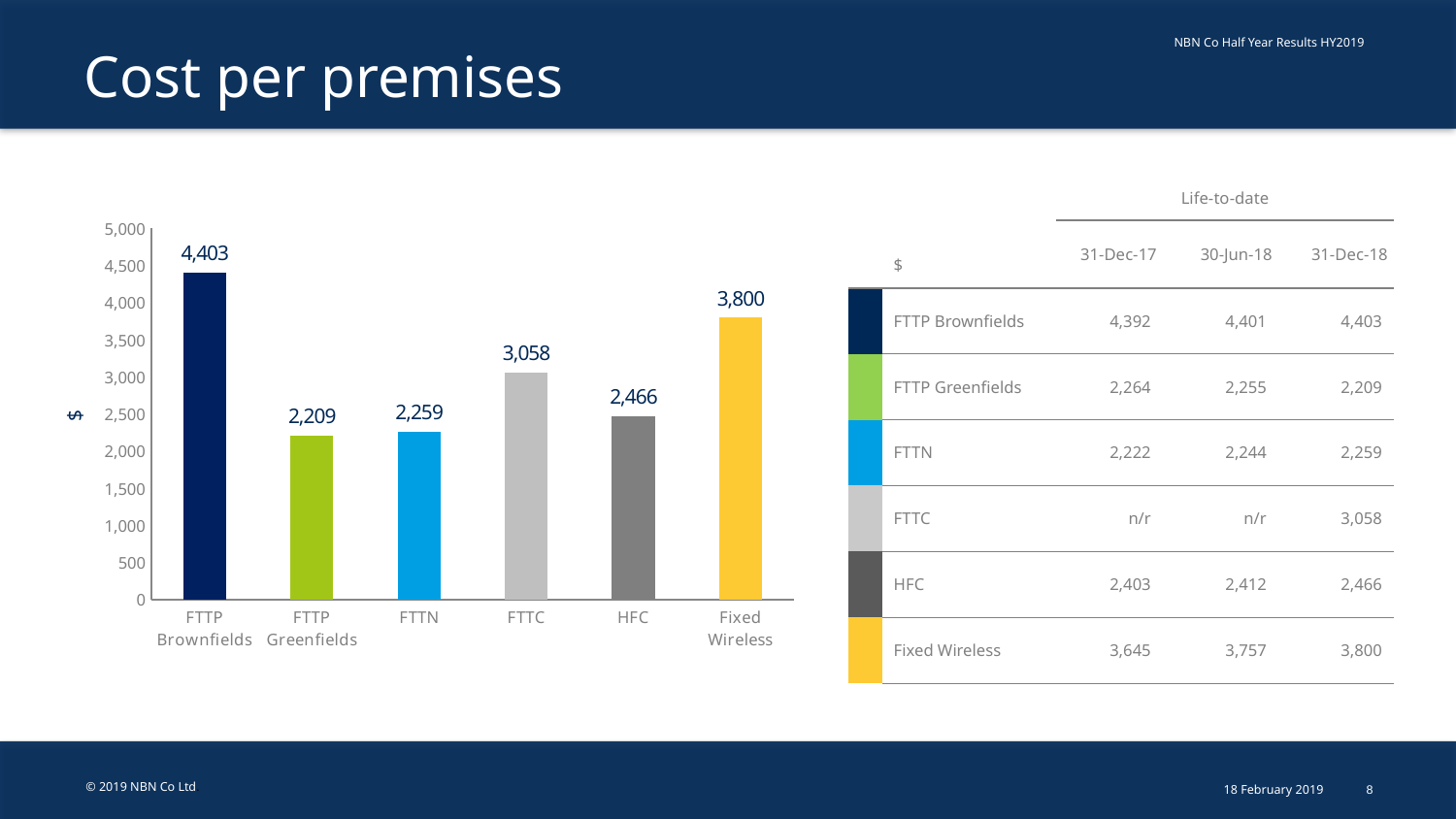
Which category has the highest cost per premises in the bar chart? FTTP Brownfields How many categories are shown in the bar chart? 6 What is the label on the vertical axis of the bar chart? $ Which category has the lowest cost per premises in the bar chart? FTTP Greenfields What is the difference in cost per premises between FTTN and FTTP Greenfields? 50 What is the cost per premises for Fixed Wireless in the bar chart? 3,800 What type of chart is shown on the slide? bar chart What is the difference in cost per premises between FTTP Brownfields and Fixed Wireless? 603 Which has a higher cost per premises, HFC or FTTC? FTTC What is the cost per premises for FTTC in the bar chart? 3,058 What is the cost per premises for FTTP Brownfields in the bar chart? 4,403 Is the cost per premises for HFC greater or less than 2,500? less